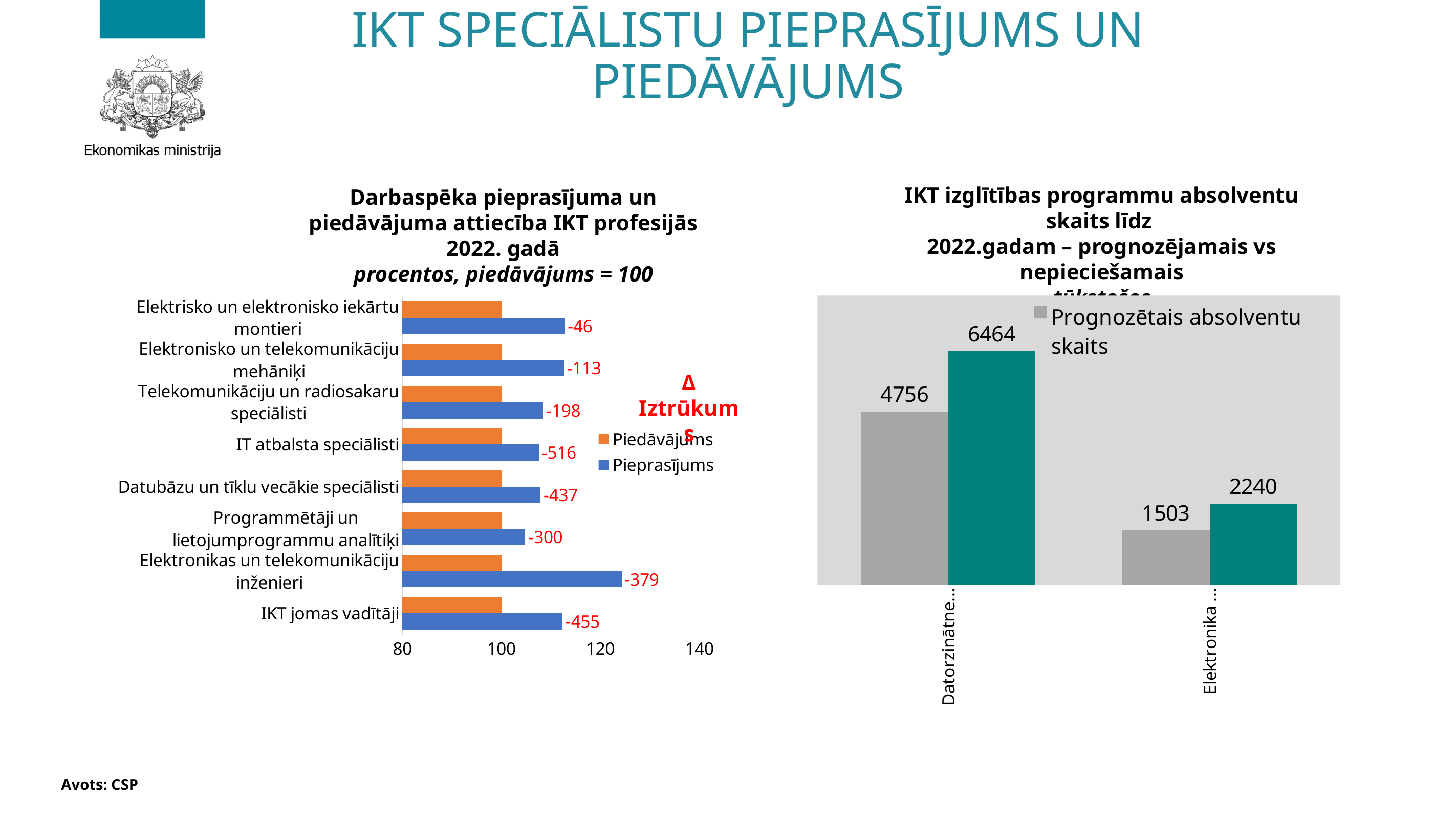
On the right chart (IKT izglītības programmu absolventu skaits), what is the Prognozētais absolventu skaits value for Datorzinātne? 4756 How many series does the legend of the left chart (Darbaspēka pieprasījuma un piedāvājuma attiecība IKT profesijās) list? 2 What are the two legend entries on the left chart (Darbaspēka pieprasījuma un piedāvājuma attiecība IKT profesijās)? Piedāvājums and Pieprasījums On the left chart (Darbaspēka pieprasījuma un piedāvājuma attiecība IKT profesijās), which category has the longest Pieprasījums bar? Elektronikas un telekomunikāciju inženieri On the left chart (Darbaspēka pieprasījuma un piedāvājuma attiecība IKT profesijās), what red Δ Iztrūkums value is shown for IT atbalsta speciālisti? -516 On the right chart (IKT izglītības programmu absolventu skaits), what is the difference between the teal bar and the grey bar for Elektronika? 737 How many categories are shown on the left chart (Darbaspēka pieprasījuma un piedāvājuma attiecība IKT profesijās)? 8 On the right chart (IKT izglītības programmu absolventu skaits), what value is shown on the teal bar for Elektronika? 2240 What kind of chart is the right chart (IKT izglītības programmu absolventu skaits)? Bar chart On the right chart (IKT izglītības programmu absolventu skaits), which category has the higher Prognozētais absolventu skaits, Datorzinātne or Elektronika? Datorzinātne On the right chart (IKT izglītības programmu absolventu skaits), what is the difference between the teal bar and the grey bar for Datorzinātne? 1708 On the left chart (Darbaspēka pieprasījuma un piedāvājuma attiecība IKT profesijās), is the Pieprasījums value for Elektronikas un telekomunikāciju inženieri greater or less than 120? greater